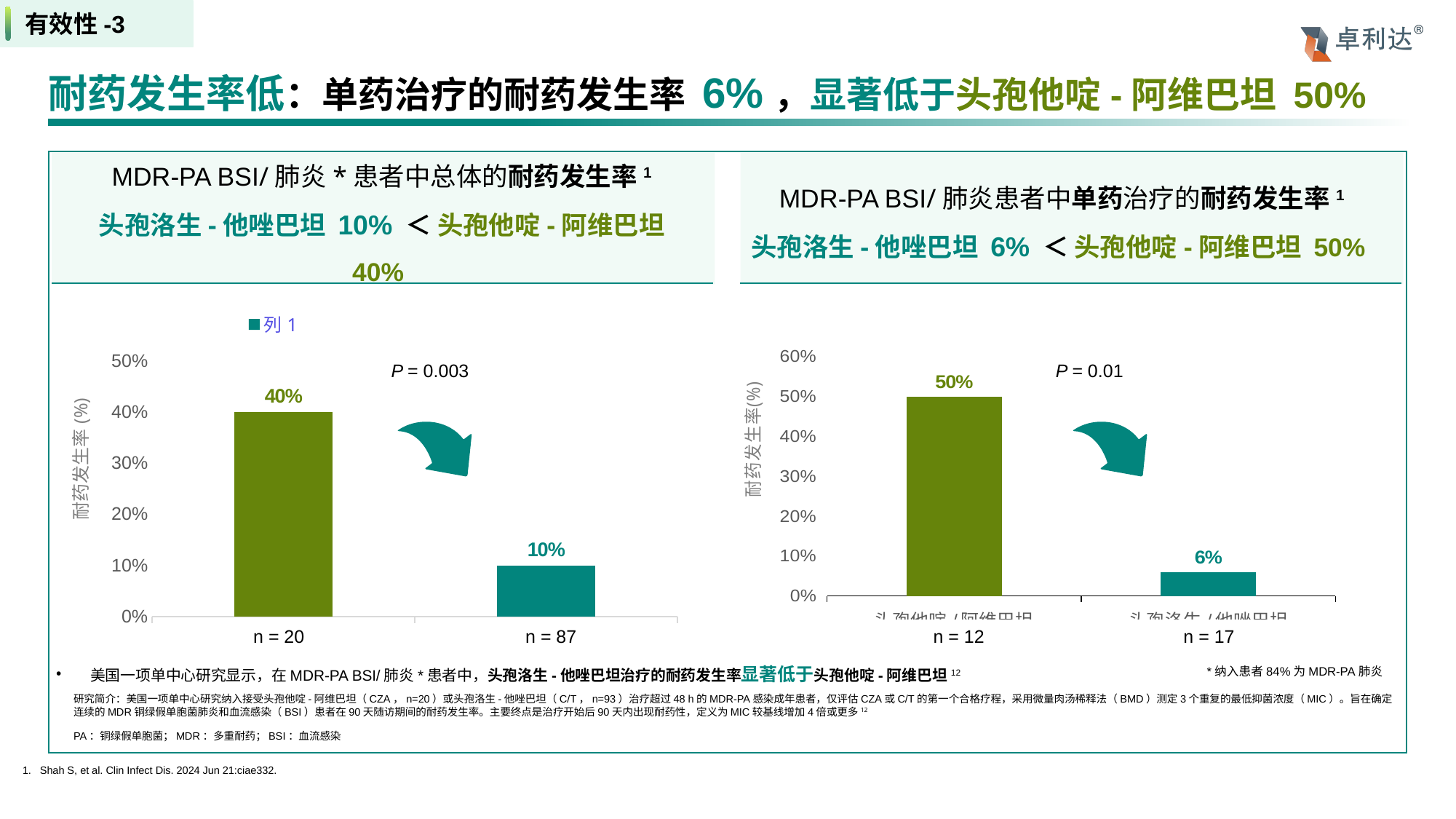
In the left chart (overall resistance rate), what is the legend entry? 列 1 In the right chart (monotherapy resistance rate), what is the value for the n = 17 bar? 6% In the left chart (overall resistance rate), what P value is shown? P = 0.003 In the right chart (monotherapy resistance rate), what is the difference between the n = 12 bar and the n = 17 bar? 44% In the right chart (monotherapy resistance rate), what is the value for the n = 12 bar? 50% In the left chart (overall resistance rate), what is the value for the n = 87 bar? 10% In the right chart (monotherapy resistance rate), which bar is the lowest? n = 17 In the left chart (overall resistance rate), what is the difference between the n = 20 bar and the n = 87 bar? 30% In the left chart (overall resistance rate), which bar is higher, n = 20 or n = 87? n = 20 What type of chart is the left chart (overall resistance rate)? Bar chart In the left chart (overall resistance rate), what is the value for the n = 20 bar? 40% How many bars are plotted in the right chart (monotherapy resistance rate)? 2